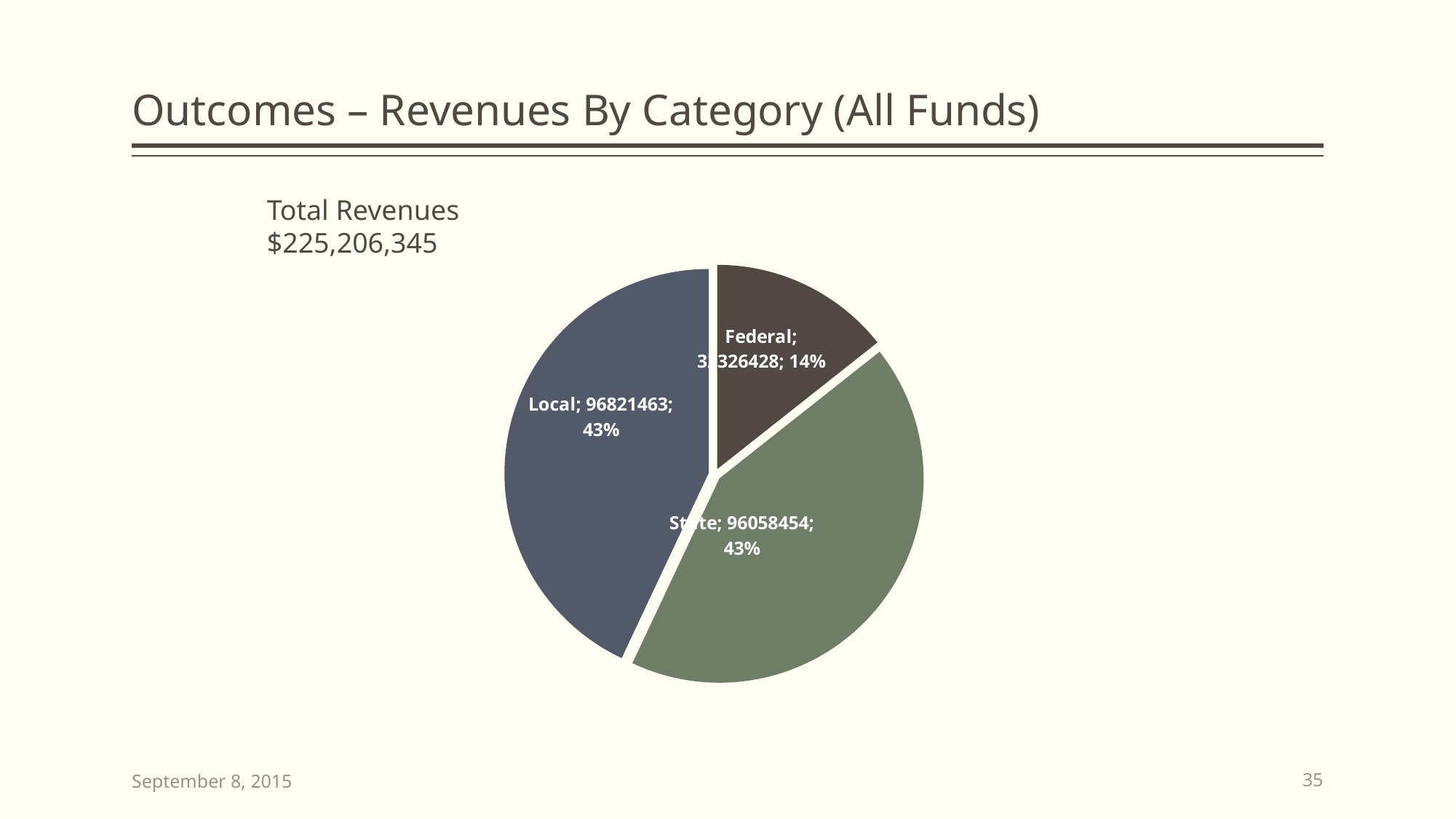
What share of the pie does Local represent? 43% Which category has the largest value in the pie chart? Local What total revenue figure is printed next to the pie chart? $225,206,345 What is the difference between the Local value and the State value? 763009 What share of the pie does Federal represent? 14% Which category has the smallest slice in the pie chart? Federal What kind of chart is shown on the slide? pie chart Which is larger, the value for Local or the value for State? Local What is the value shown for Local in the pie chart? 96821463 What share of the pie does State represent? 43% What is the value shown for State in the pie chart? 96058454 How many slices does the pie chart have? 3